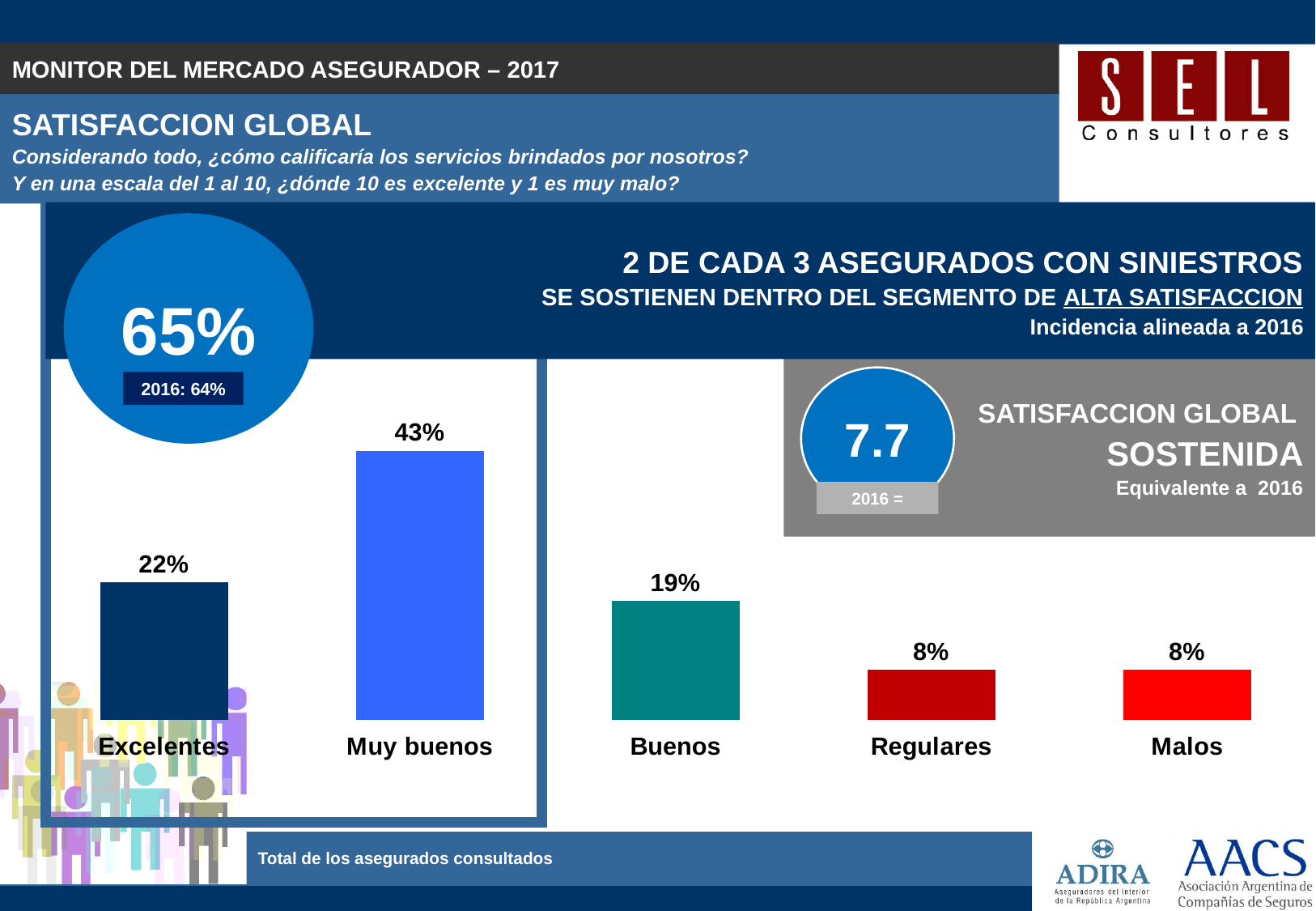
What is the value for Muy buenos? 43% What is the difference between the values for Muy buenos and Excelentes? 21% Which category has the highest value? Muy buenos How many categories are shown in the bar chart? 5 What colour is the bar for Buenos? Teal green What is the combined value of Excelentes and Muy buenos? 65% What is the value for Regulares? 8% What kind of chart is shown on the slide? Bar chart What is the value for Excelentes? 22% What is the value for Buenos? 19% Which is larger, the value for Excelentes or the value for Buenos? Excelentes What is the difference between the values for Buenos and Malos? 11%